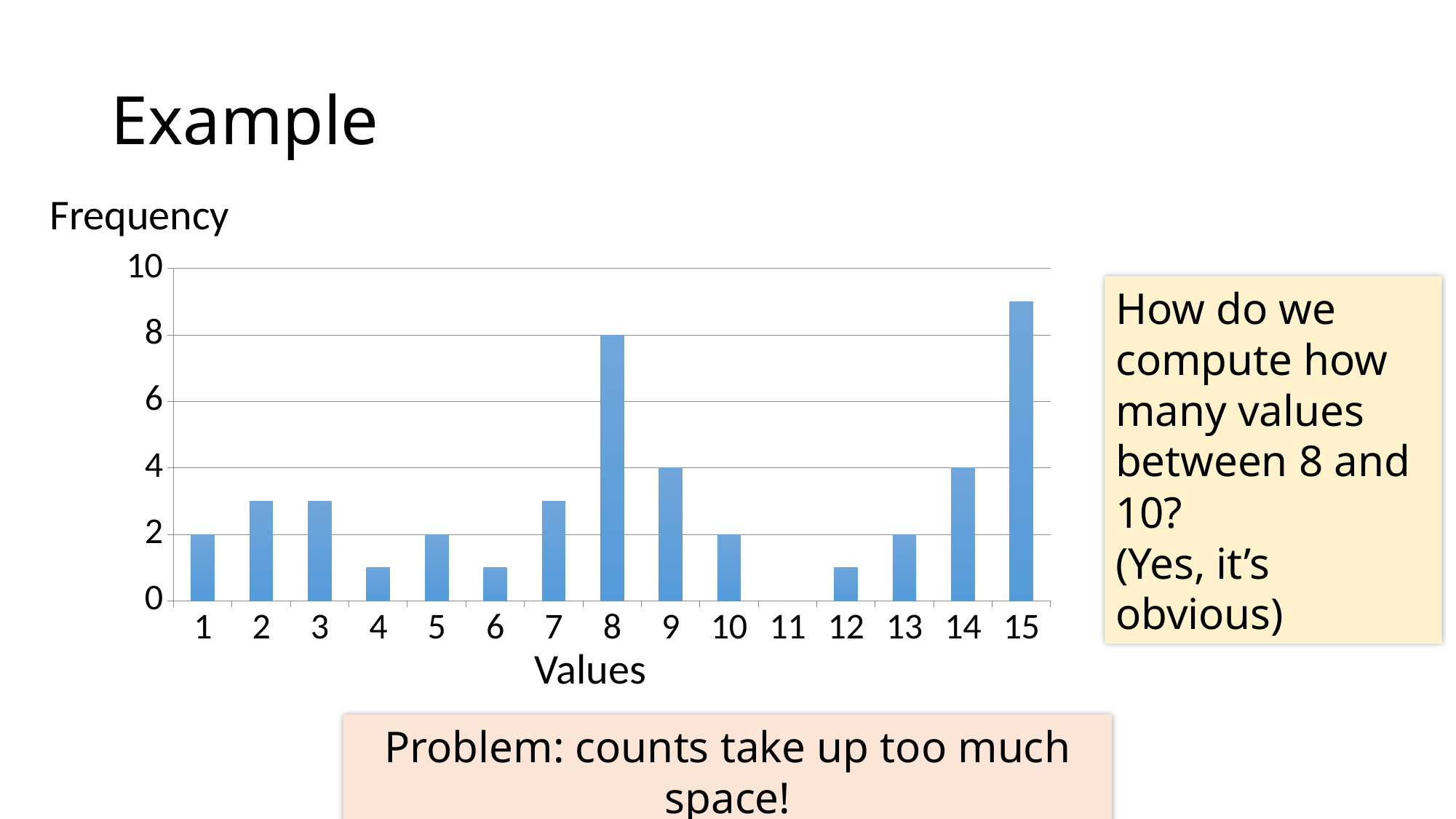
What is the frequency for value 10? 2 What is the frequency for value 8? 8 What kind of chart is shown on the slide? bar chart How many values are shown along the x axis of the chart? 15 Which has a higher frequency, value 8 or value 14? value 8 Which value has the highest frequency? 15 What is the frequency for value 14? 4 Is the frequency for value 15 greater or less than 8? greater What is the label of the x axis? Values What is the frequency for value 9? 4 What is the difference between the frequency for value 8 and the frequency for value 9? 4 Which value has the lowest frequency (no bar at all)? 11